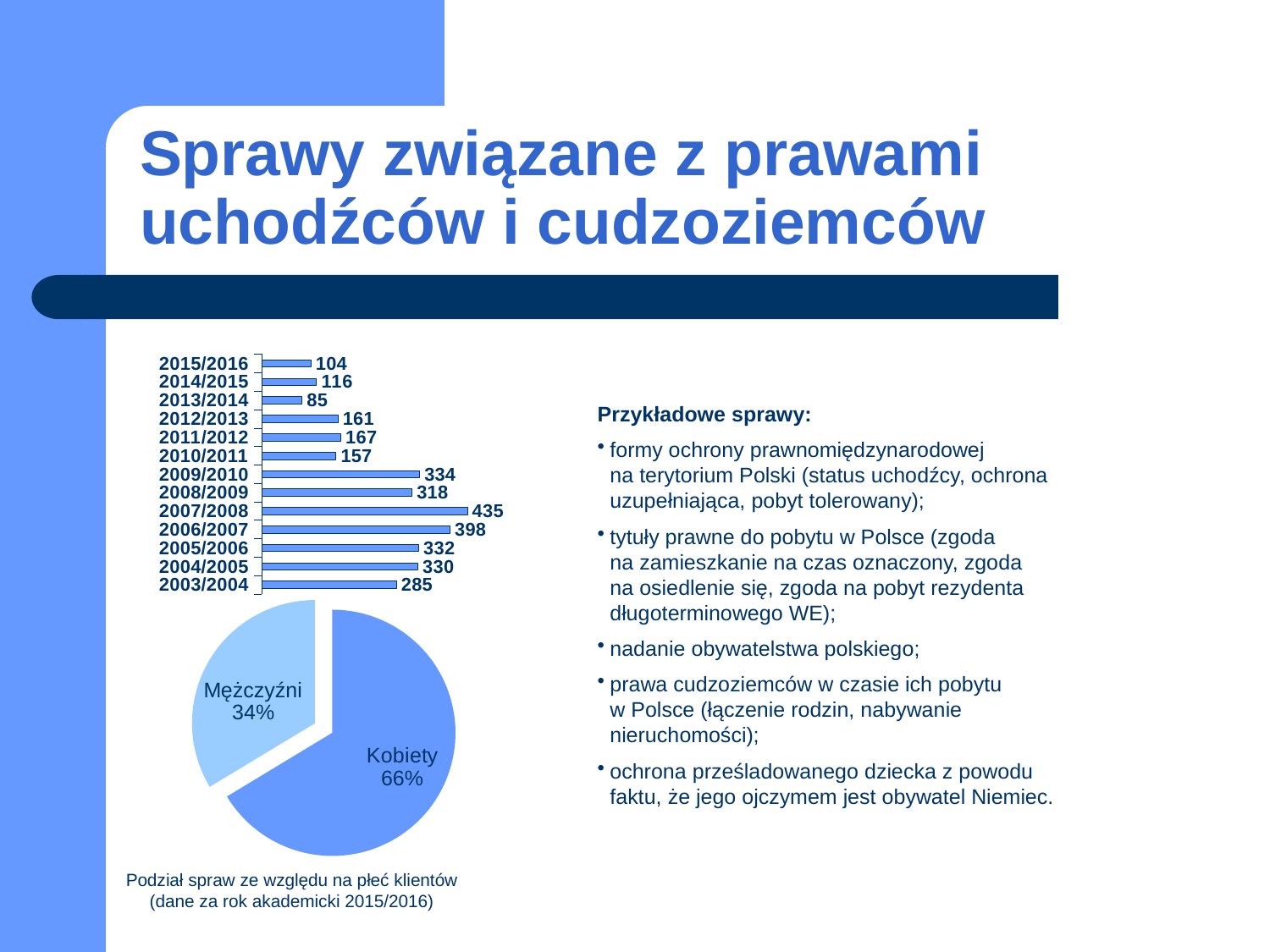
In the bar chart, which academic year has the lowest value? 2013/2014 How many academic years are shown in the bar chart? 13 In the bar chart, what is the difference between the values for 2009/2010 and 2008/2009? 16 In the bar chart, which is larger: the value for 2011/2012 or the value for 2010/2011? 2011/2012 In the bar chart, what is the value for 2003/2004? 285 In the pie chart, what share is labelled Mężczyźni? 34% In the pie chart, what share is labelled Kobiety? 66% In the bar chart, what is the value for 2007/2008? 435 In the bar chart, which academic year has the highest value? 2007/2008 How many slices does the pie chart have? 2 In the bar chart, what is the value for 2013/2014? 85 What type of chart is the upper chart on the slide? bar chart